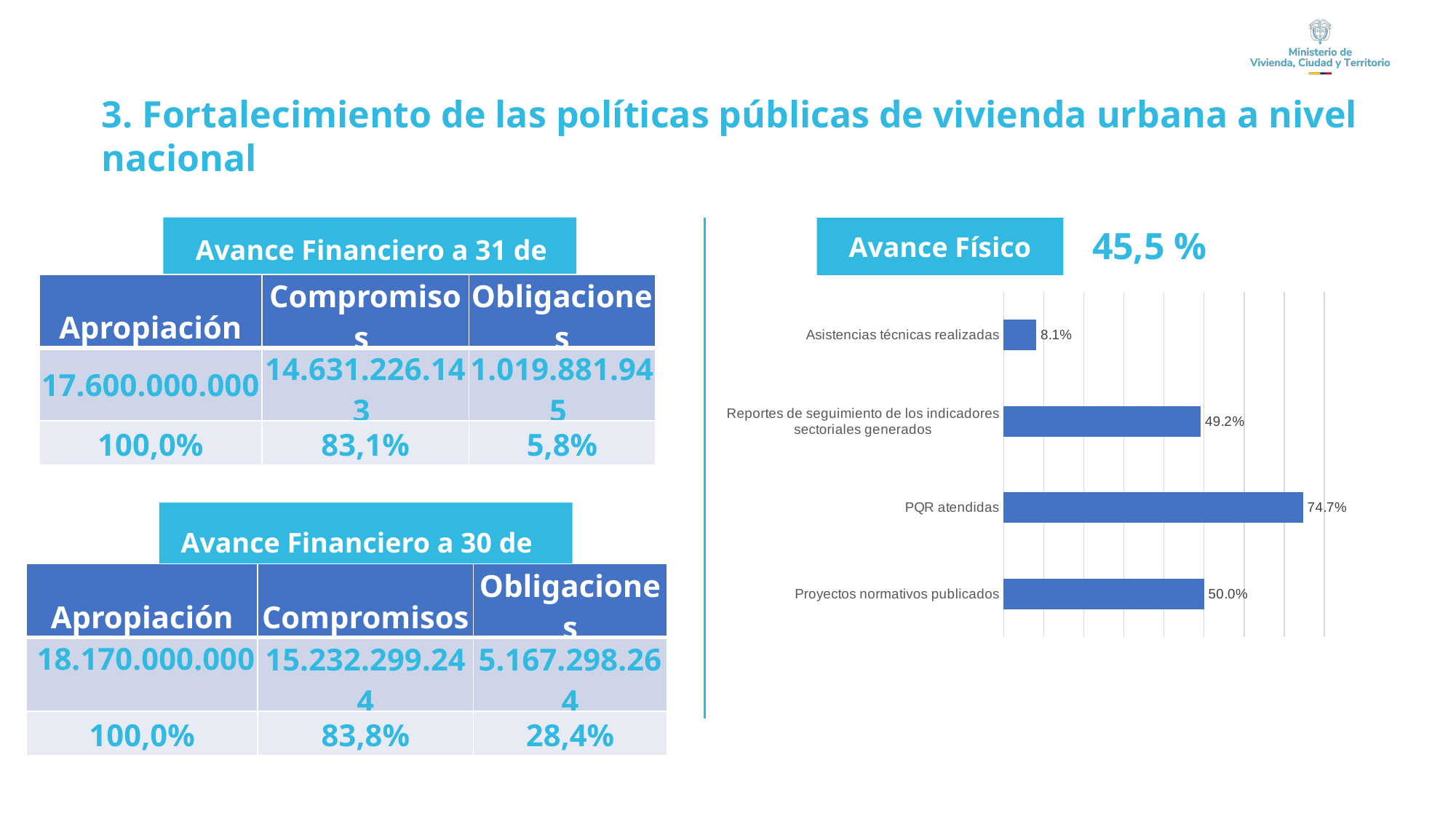
Which category has the lowest value in the Avance Físico chart? Asistencias técnicas realizadas In the Avance Físico chart, what is the difference between the values for PQR atendidas and Asistencias técnicas realizadas? 66.6% Which category has the highest value in the Avance Físico chart? PQR atendidas What is the value for Reportes de seguimiento de los indicadores sectoriales generados in the Avance Físico chart? 49.2% What is the value for Proyectos normativos publicados in the Avance Físico chart? 50.0% What is the overall percentage shown next to the Avance Físico heading? 45,5 % How many categories are shown in the Avance Físico chart? 4 In the Avance Físico chart, what is the difference between the values for PQR atendidas and Proyectos normativos publicados? 24.7% What kind of chart is the Avance Físico chart? Bar chart What is the value for PQR atendidas in the Avance Físico chart? 74.7% In the Avance Físico chart, which is larger: the value for PQR atendidas or the value for Reportes de seguimiento de los indicadores sectoriales generados? PQR atendidas What is the value for Asistencias técnicas realizadas in the Avance Físico chart? 8.1%